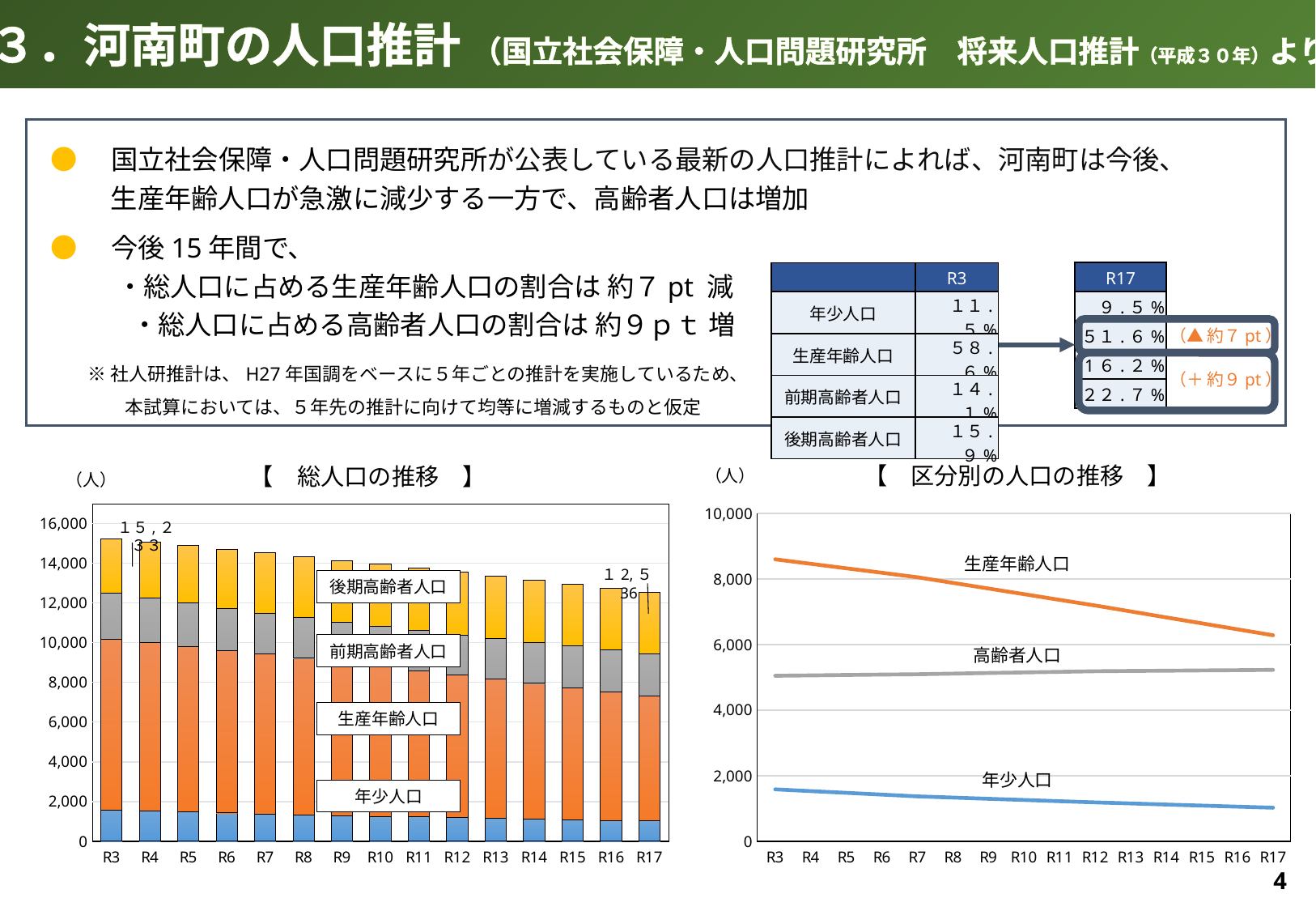
How many lines (series) are plotted in the 区分別の人口の推移 chart? 3 What kind of chart is the 総人口の推移 chart on the left? bar chart In the 総人口の推移 chart, what is the total population shown for R17? 12,536 In the 区分別の人口の推移 chart, is the value of 生産年齢人口 at R3 greater or less than 8,000? greater In the 区分別の人口の推移 chart, does 生産年齢人口 rise or fall from R3 to R17? fall In the 総人口の推移 chart, does the total population rise or fall from R3 to R17? fall How many years (categories) are shown on the x axis of the 総人口の推移 chart? 15 In the 区分別の人口の推移 chart, which series has the lowest values across all years? 年少人口 In the 総人口の推移 chart, what is the total population shown for R3? 15,233 In the 総人口の推移 chart, what is the difference between the R3 total and the R17 total? 2,697 In the 総人口の推移 chart, is the 年少人口 segment for R3 greater or less than 2,000? less What kind of chart is the 区分別の人口の推移 chart on the right? line chart